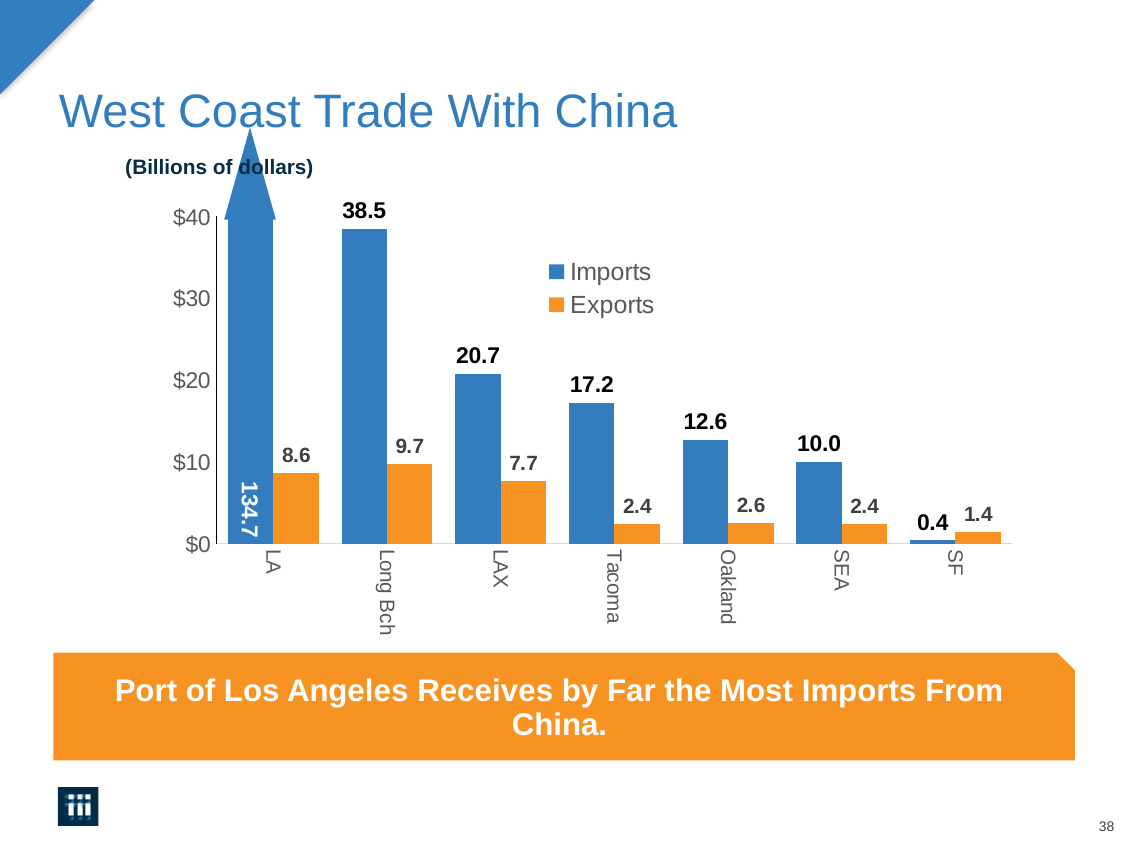
Which port has the lowest Imports value? SF What unit is stated for the values in the chart? Billions of dollars What is the Exports value for LAX? 7.7 What is the Imports value for LA? 134.7 How many ports are shown on the x axis? 7 Is the Imports value for Oakland greater or less than $10? greater What is the Imports value for Long Bch? 38.5 What kind of chart is shown on the slide? Bar chart How many series does the legend list? 2 Which port has the highest Imports value? LA What is the difference between Imports and Exports for Tacoma? 14.8 Which is larger for SF, Imports or Exports? Exports